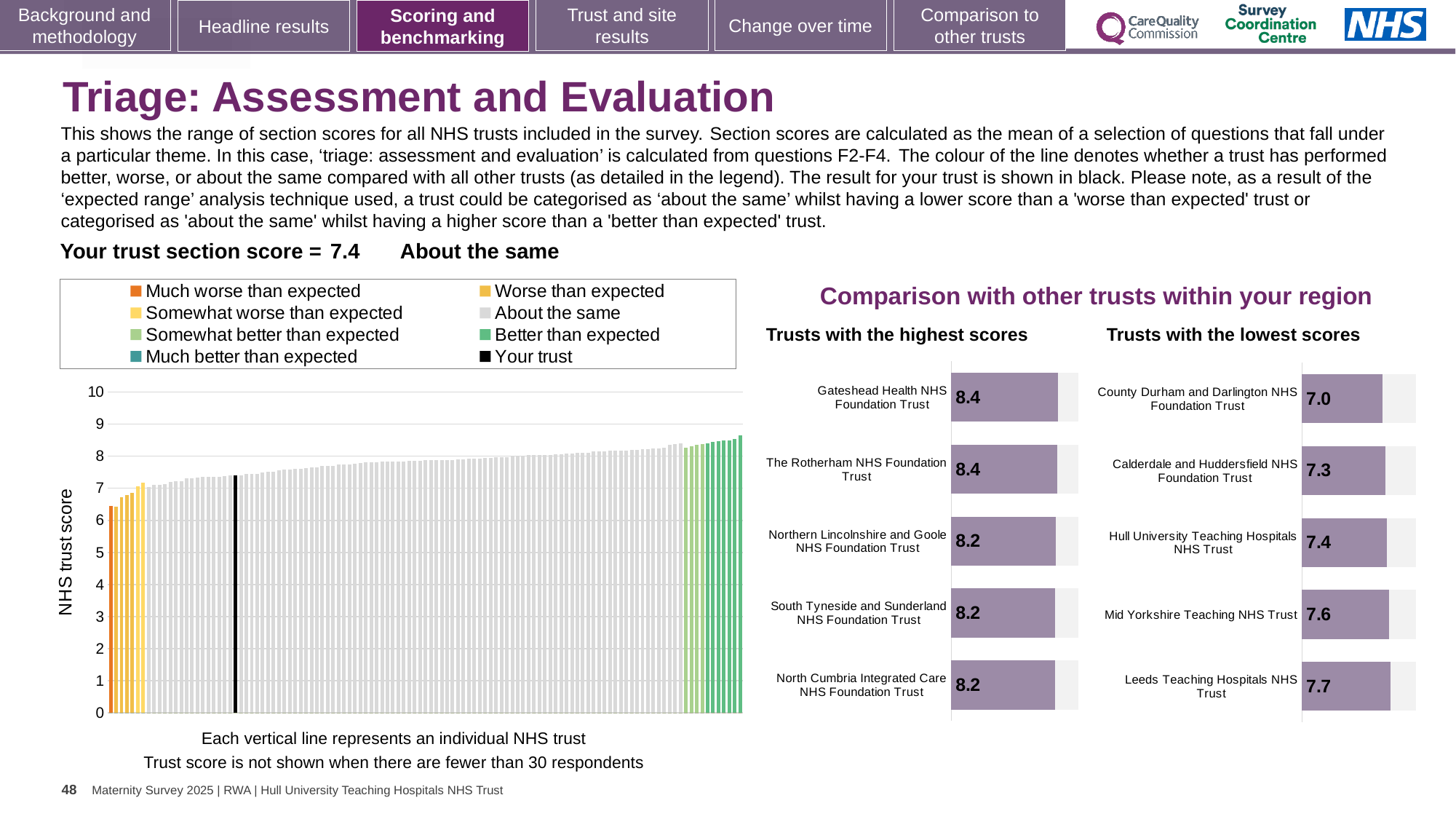
In the 'Trusts with the highest scores' chart, what is the score for Gateshead Health NHS Foundation Trust? 8.4 In the 'Trusts with the lowest scores' chart, which trust has the lowest score? County Durham and Darlington NHS Foundation Trust In the main 'NHS trust score' chart on the left, is the value for your trust (the black bar) greater or less than 8? less How many entries does the legend above the main 'NHS trust score' chart list? 8 In the 'Trusts with the lowest scores' chart, what is the difference between the scores of Leeds Teaching Hospitals NHS Trust and County Durham and Darlington NHS Foundation Trust? 0.7 How many trusts are shown in the 'Trusts with the highest scores' chart? 5 In the 'Trusts with the lowest scores' chart, what is the score for Hull University Teaching Hospitals NHS Trust? 7.4 In the 'Trusts with the highest scores' chart, what is the difference between the scores of Gateshead Health NHS Foundation Trust and North Cumbria Integrated Care NHS Foundation Trust? 0.2 In the 'Trusts with the lowest scores' chart, which trust has the highest score? Leeds Teaching Hospitals NHS Trust In the main 'NHS trust score' chart on the left, do the bar values rise or fall from left to right? rise In the main 'NHS trust score' chart on the left, what is the section score for your trust (the black bar)? 7.4 In the 'Trusts with the lowest scores' chart, which has the higher score: Hull University Teaching Hospitals NHS Trust or Mid Yorkshire Teaching NHS Trust? Mid Yorkshire Teaching NHS Trust